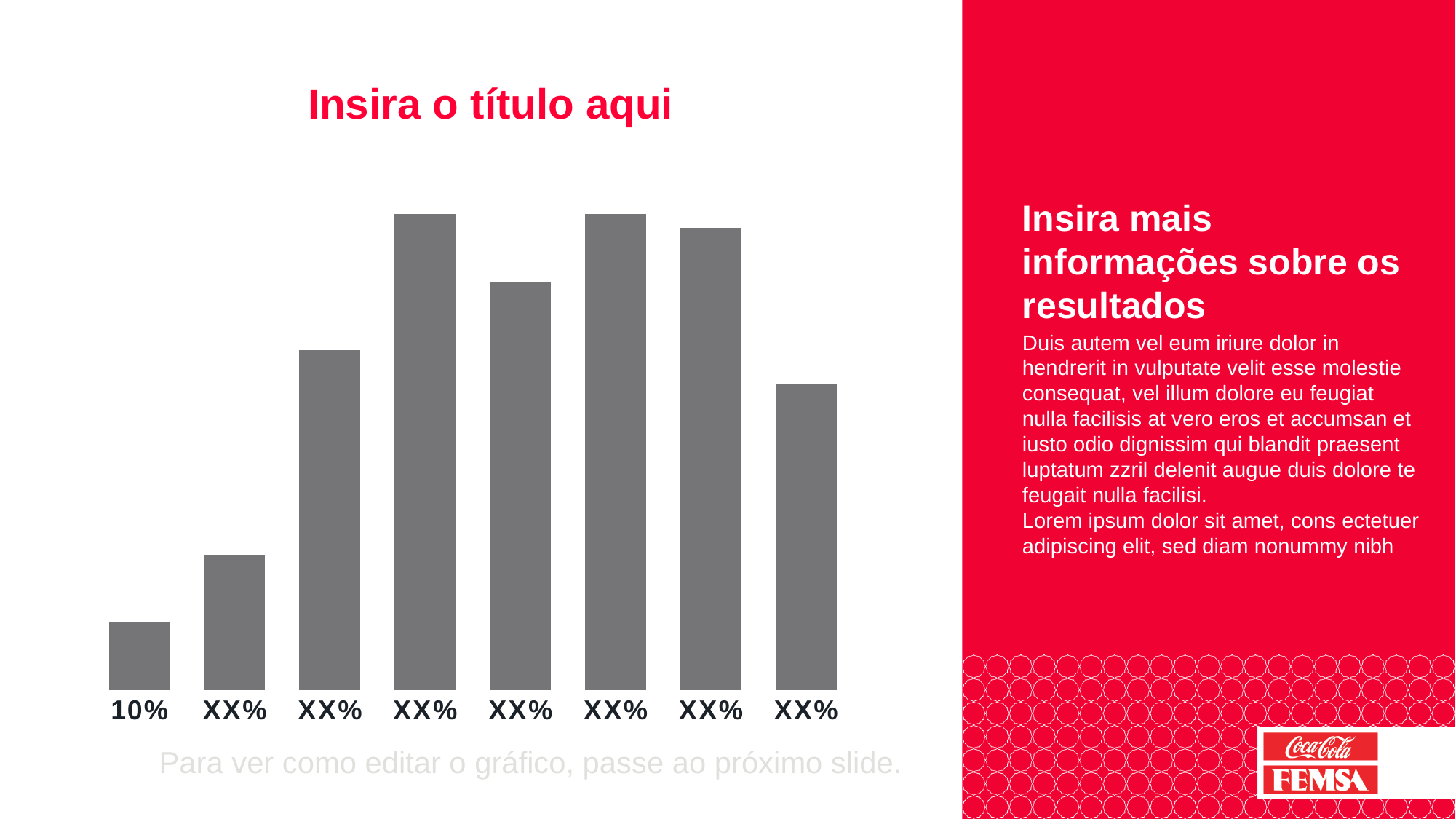
How many bars does the chart contain? 8 Which is taller, the fourth bar or the fifth bar? the fourth bar Which is taller, the seventh bar or the eighth bar? the seventh bar Do the bar heights rise or fall from the first bar to the fourth bar? rise Which is taller, the third bar or the fifth bar? the fifth bar What kind of chart is shown on the slide? bar chart What is the title shown above the chart? Insira o título aqui What label appears under the first (leftmost) bar of the chart? 10% Do the bar heights rise or fall from the sixth bar to the eighth bar? fall Which bar is the shortest in the chart? the first bar (labelled 10%)